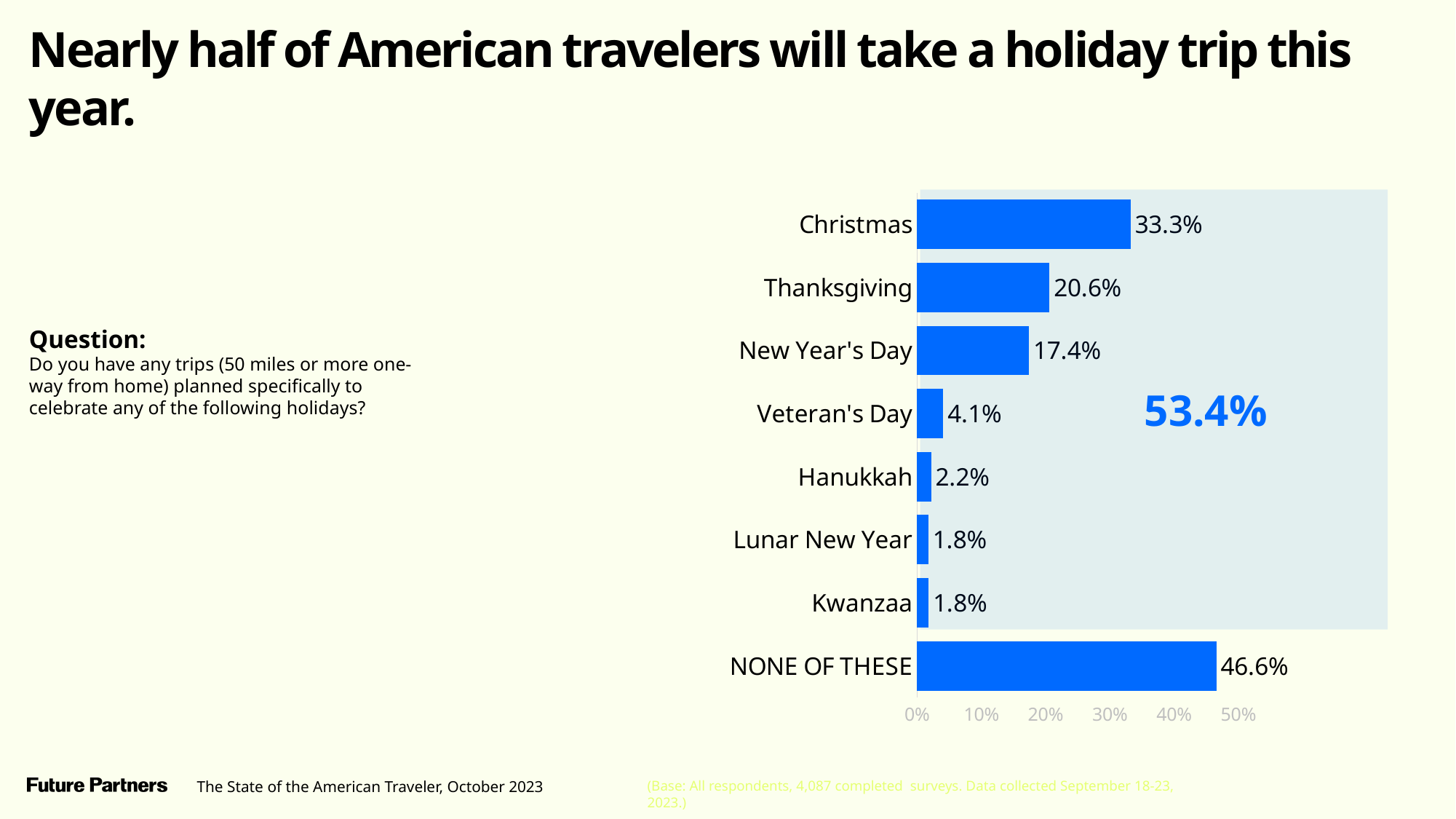
Which holiday has the highest percentage of planned trips? Christmas What is the difference between the Christmas and Thanksgiving values? 12.7% Which category has the largest bar overall in the chart? NONE OF THESE Which is larger, the value for New Year's Day or the value for Thanksgiving? Thanksgiving What type of chart is shown on the slide? Bar chart What percentage is shown for NONE OF THESE? 46.6% What large highlighted percentage is printed inside the shaded area of the chart? 53.4% What is the value shown for Thanksgiving? 20.6% What percentage of travelers have a trip planned for Christmas? 33.3% What is the difference between the Hanukkah and Lunar New Year values? 0.4% What is the value for Veteran's Day? 4.1% How many categories are shown in the bar chart? 8